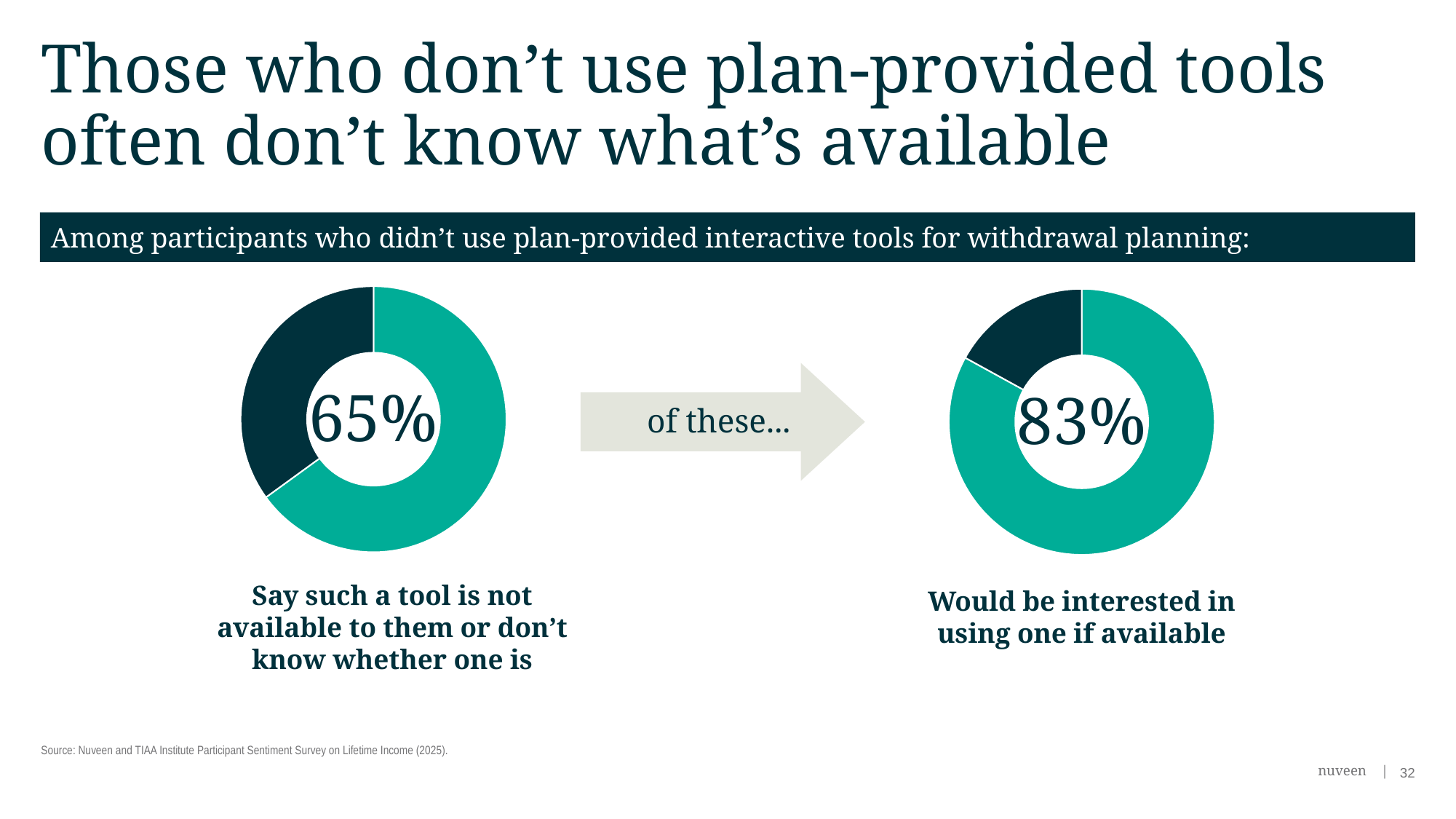
On the left donut chart, what percentage of participants say such a tool is not available to them or don't know whether one is? 65% What kind of chart is used on the right side of the slide? Donut chart What is the difference between the percentage in the right donut chart and the percentage in the left donut chart? 18 percentage points What text appears in the arrow between the two donut charts? of these... On the right donut chart, what percentage would be interested in using one if available? 83% How many donut charts are shown on the slide? 2 Which is larger: the percentage shown in the left donut chart or the percentage shown in the right donut chart? The right donut chart (83%) What kind of chart is used on the left side of the slide? Donut chart On the right donut chart, is the highlighted teal share greater or less than 50%? greater On the left donut chart, which colour represents the 65% share? Teal (green)